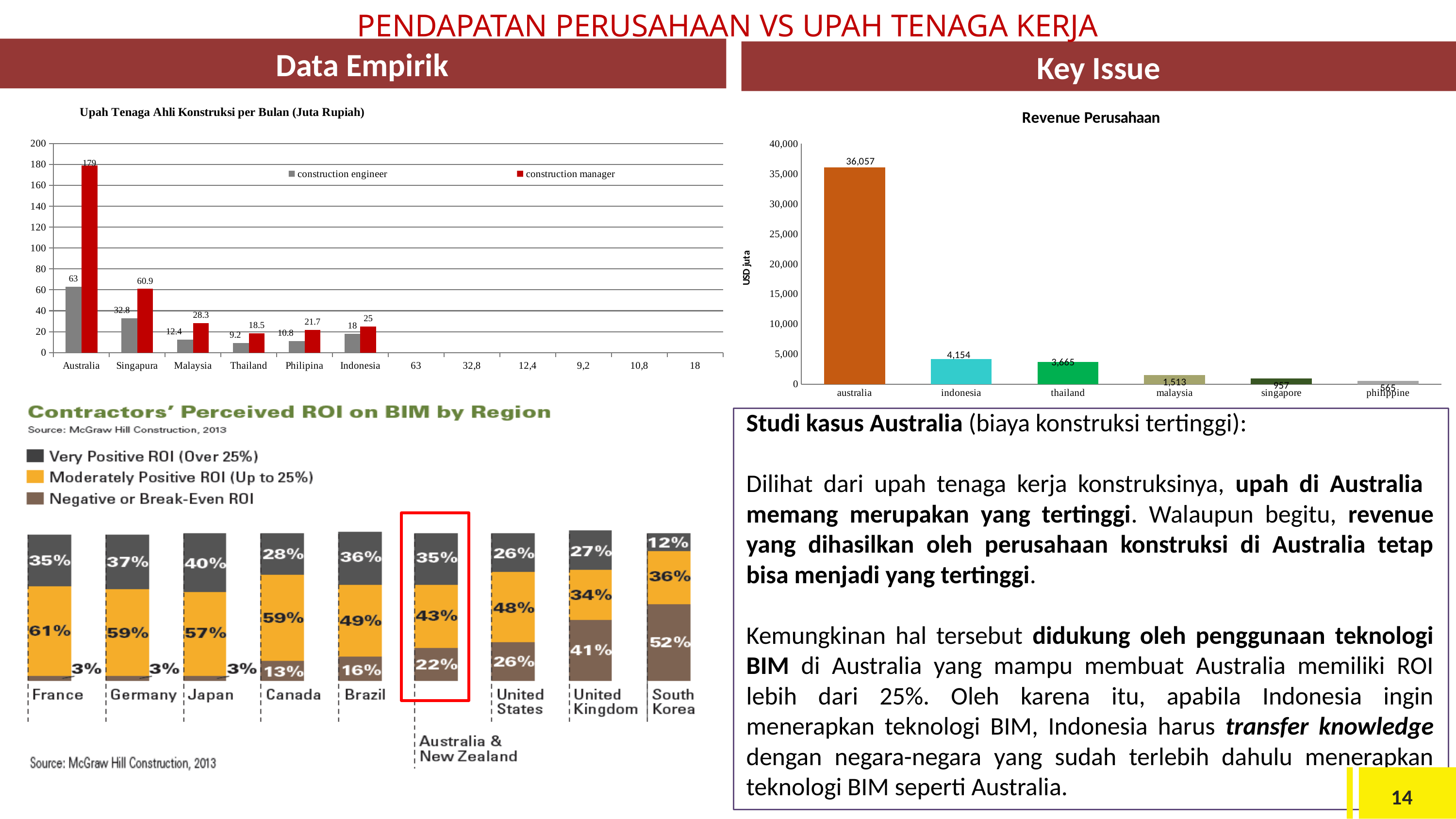
In the 'Upah Tenaga Ahli Konstruksi per Bulan' chart, what is the value for construction manager in Australia? 179 In the 'Upah Tenaga Ahli Konstruksi per Bulan' chart, what is the difference between the construction manager and construction engineer values for Singapura? 28.1 In the 'Upah Tenaga Ahli Konstruksi per Bulan' chart, what is the value for construction engineer in Indonesia? 18 In the 'Revenue Perusahaan' chart, which country has the highest revenue? australia In the 'Revenue Perusahaan' chart, how many countries are shown? 6 In the 'Contractors' Perceived ROI on BIM by Region' chart, what is the Very Positive ROI share for Japan? 40% In the 'Revenue Perusahaan' chart, which country has the lowest revenue? philippine In the 'Revenue Perusahaan' chart, what is the value for indonesia? 4,154 In the 'Upah Tenaga Ahli Konstruksi per Bulan' chart, which country has the lowest construction engineer value? Thailand In the 'Contractors' Perceived ROI on BIM by Region' chart, which region has the highest Negative or Break-Even ROI share? South Korea In the 'Upah Tenaga Ahli Konstruksi per Bulan' chart, how many series does the legend list? 2 In the 'Revenue Perusahaan' chart, what is the difference between the values for thailand and malaysia? 2,152